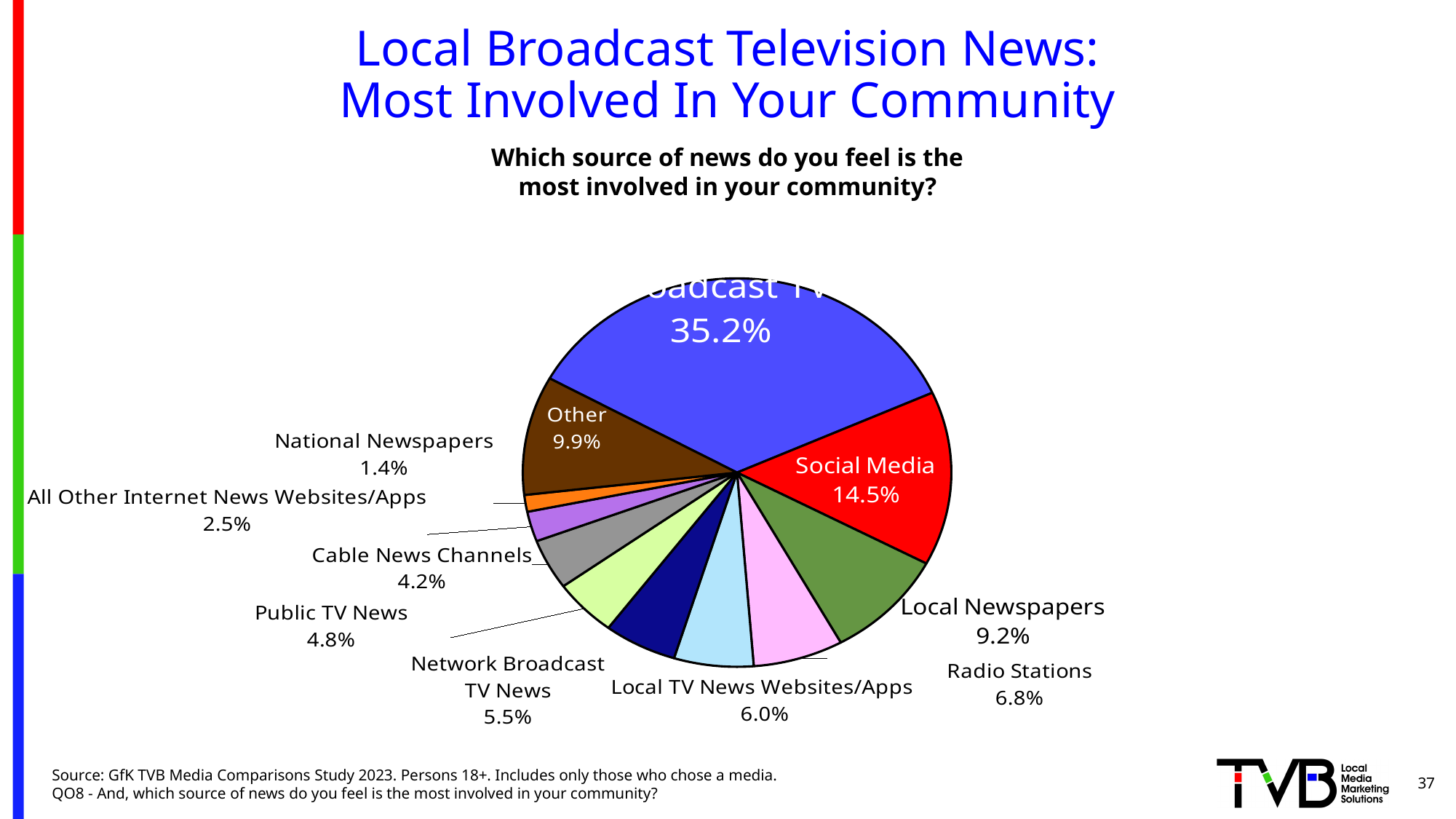
What kind of chart is shown on the slide? pie chart Which is larger, Public TV News or Network Broadcast TV News? Network Broadcast TV News What is the value shown for Local Newspapers? 9.2% What question is the chart based on, as stated in bold above the pie? Which source of news do you feel is the most involved in your community? What is the value shown for Radio Stations? 6.8% How many slices does the pie chart have? 11 Which category has the smallest slice of the pie? National Newspapers What is the difference between the values for Social Media and Local Newspapers? 5.3% What is the percentage shown on the largest slice of the pie? 35.2% What is the value shown for the Other slice? 9.9% What is the value shown for Cable News Channels? 4.2% What share of the pie does Social Media hold? 14.5%